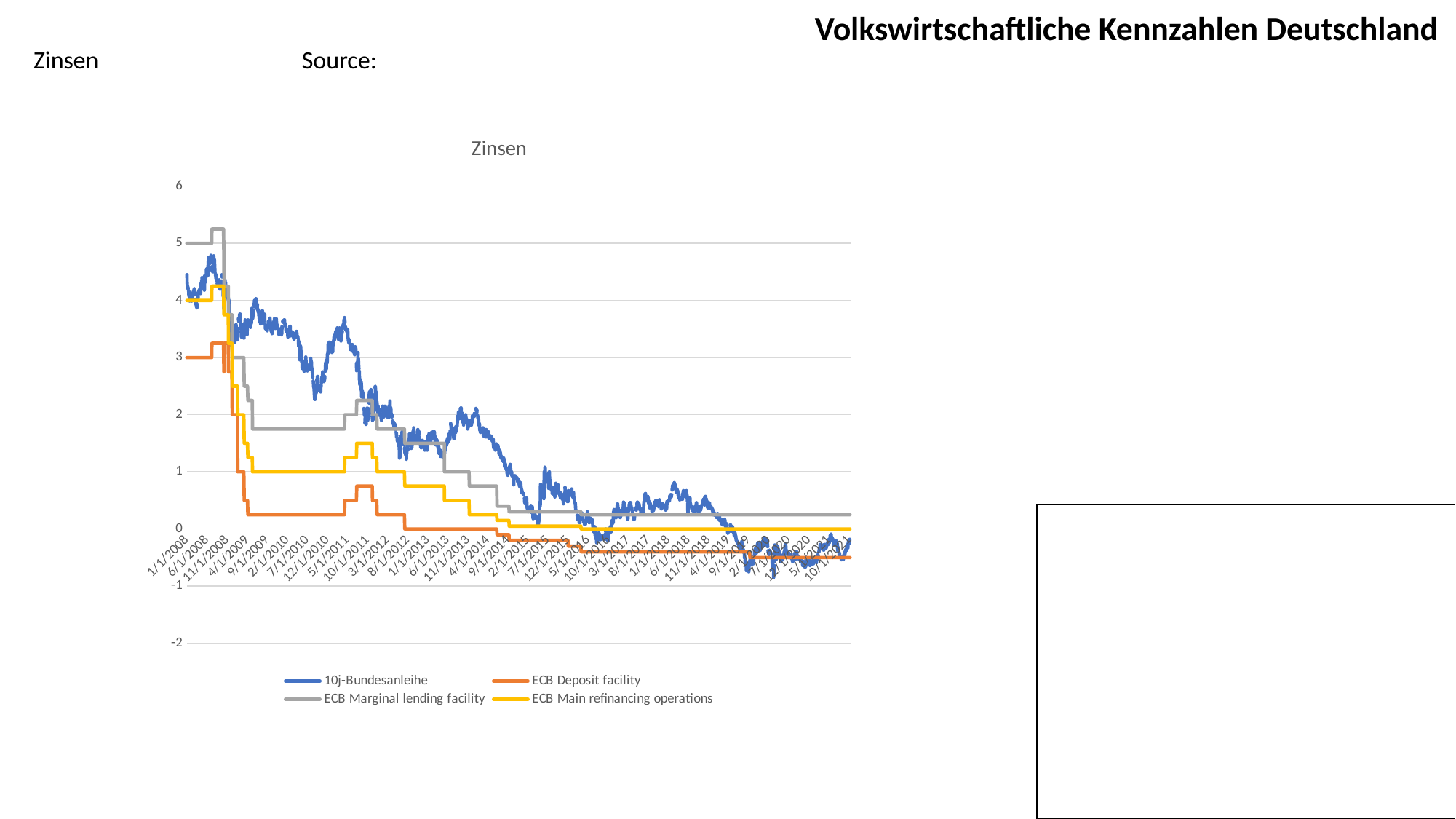
Is the value of 10j-Bundesanleihe at 1/1/2008 greater or less than 4? greater Is the value of ECB Deposit facility at 1/1/2008 greater or less than 2? greater Does the 10j-Bundesanleihe series rise or fall overall from 1/1/2008 to 10/1/2021? fall Which series has the highest value at the start of the chart (1/1/2008)? ECB Marginal lending facility What is the title of the chart? Zinsen Is the value of ECB Marginal lending facility at 1/1/2008 greater or less than 4? greater What kind of chart is shown on the slide? line chart Which colour is used for the 10j-Bundesanleihe series? blue How many series does the legend of the chart list? 4 At 10/1/2021, which is higher: ECB Marginal lending facility or ECB Deposit facility? ECB Marginal lending facility Which series has the lowest value at the start of the chart (1/1/2008)? ECB Deposit facility